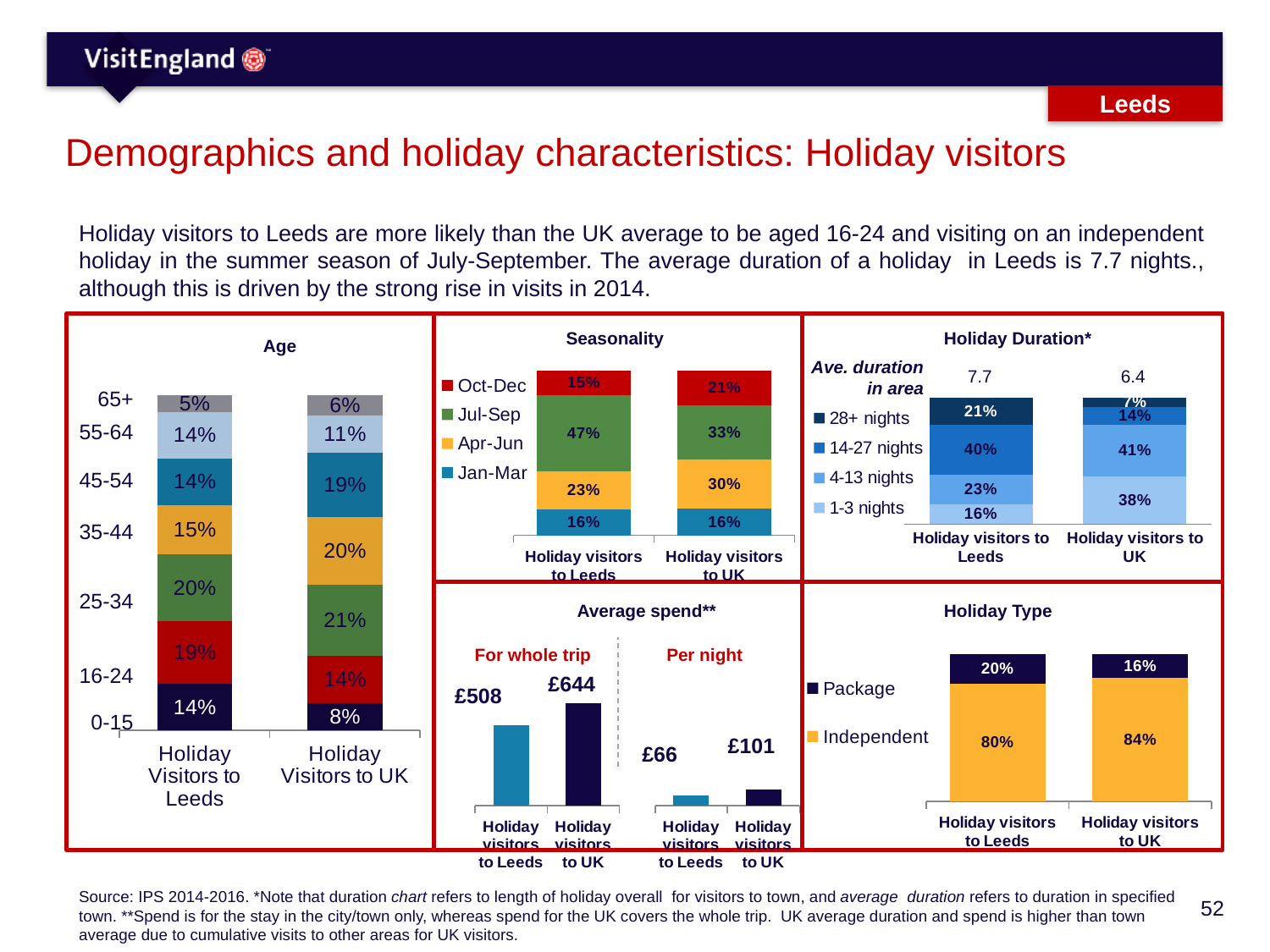
In the Age chart, which age group has the smallest share of holiday visitors to Leeds? 65+ How many series does the legend of the Seasonality chart list? 4 In the Average spend chart, which is larger, the per night spend for holiday visitors to Leeds or for holiday visitors to UK? Holiday visitors to UK In the Holiday Duration chart, what is the average duration in area for holiday visitors to Leeds? 7.7 In the Seasonality chart, what is the difference between the Jul-Sep share for holiday visitors to Leeds and for holiday visitors to UK? 14% In the Holiday Type chart, what percentage of holiday visitors to Leeds are on a package holiday? 20% In the Average spend chart, what is the spend for the whole trip for holiday visitors to Leeds? £508 What kind of chart is the Holiday Type chart? Stacked bar chart In the Seasonality chart, what percentage of holiday visitors to Leeds visit in Jul-Sep? 47% In the Age chart, what percentage of holiday visitors to UK are aged 0-15? 8% In the Age chart, what percentage of holiday visitors to Leeds are aged 16-24? 19% In the Holiday Duration chart, what percentage of holiday visitors to UK stay 1-3 nights? 38%